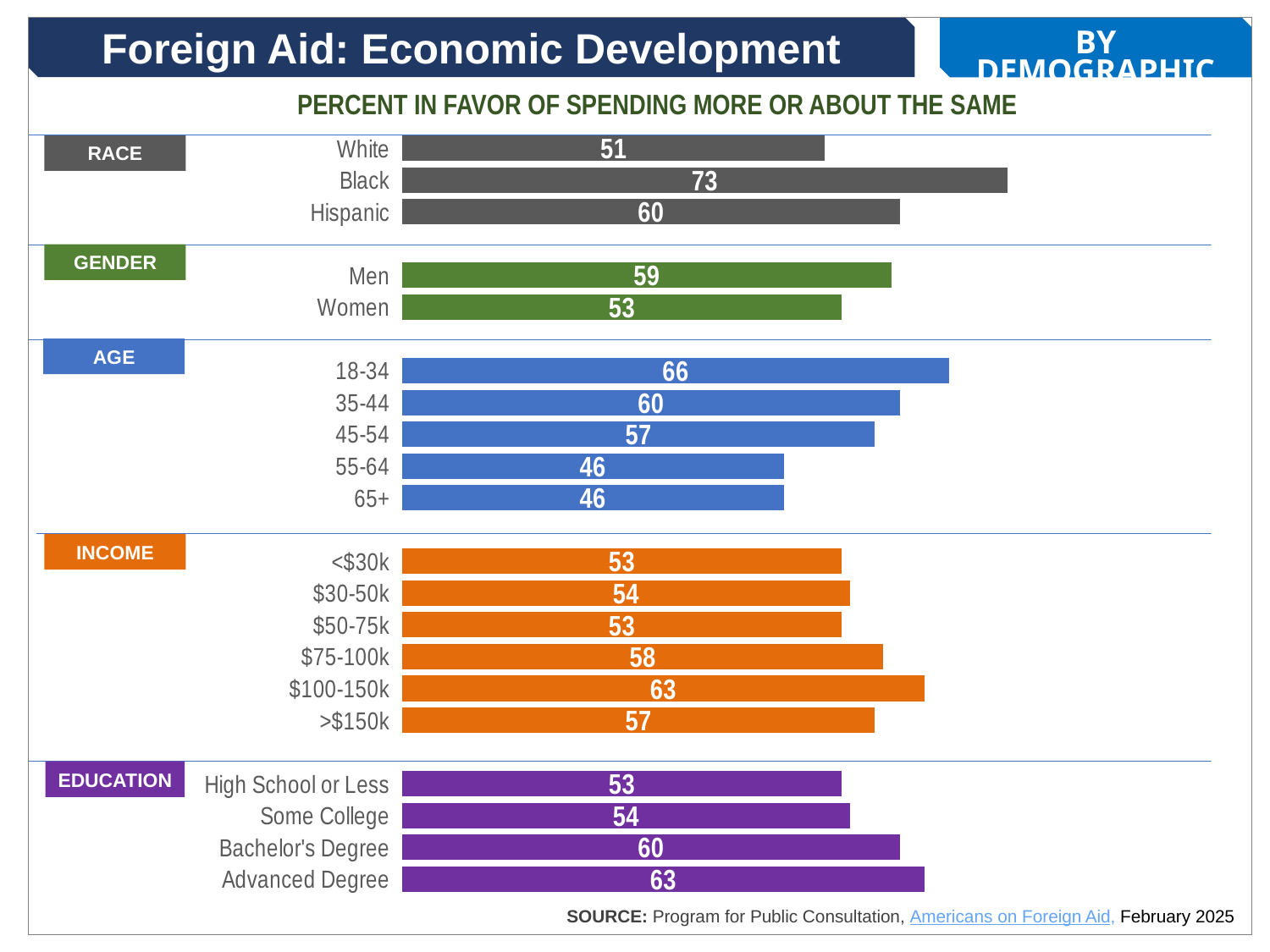
What is the value shown for respondents with an Advanced Degree? 63 What kind of chart is shown on the slide? Bar chart What is the difference between the values for Men and Women? 6 How many bars are plotted on the chart in total? 20 What colour are the bars for the Income group? Orange What is the value shown for the 18-34 age group? 66 What is the difference between the values for the 18-34 and 65+ age groups? 20 Which has a higher value, White or Hispanic respondents? Hispanic Which income group has the lowest value? <$30k and $50-75k (both 53) Do the values rise or fall as the age groups go from 18-34 to 65+? Fall Which demographic group on the slide has the highest value? Black What percent of Black respondents favor spending more or about the same on economic development foreign aid? 73